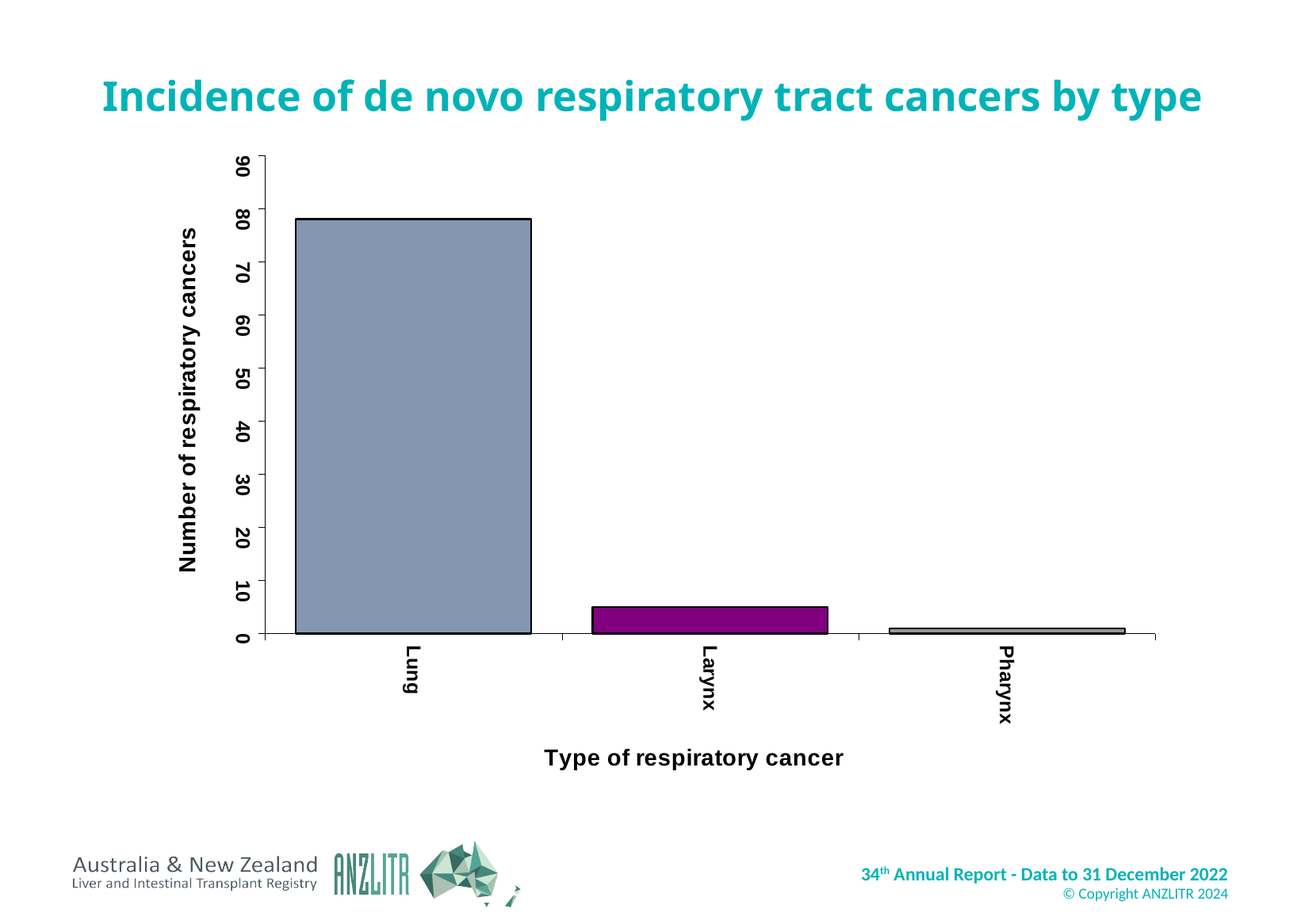
Which has more cases, Lung or Larynx? Lung Is the value for Lung greater or less than 80? less Which type of respiratory cancer has the highest number of cases? Lung Is the value for Larynx greater or less than 10? less Which type of respiratory cancer has the lowest number of cases? Pharynx How many types of respiratory cancer are shown on the x axis? 3 What is the title of the chart? Incidence of de novo respiratory tract cancers by type What kind of chart is shown on the slide? bar chart Is the value for Pharynx greater or less than 10? less What is the label of the y axis? Number of respiratory cancers Which has more cases, Larynx or Pharynx? Larynx